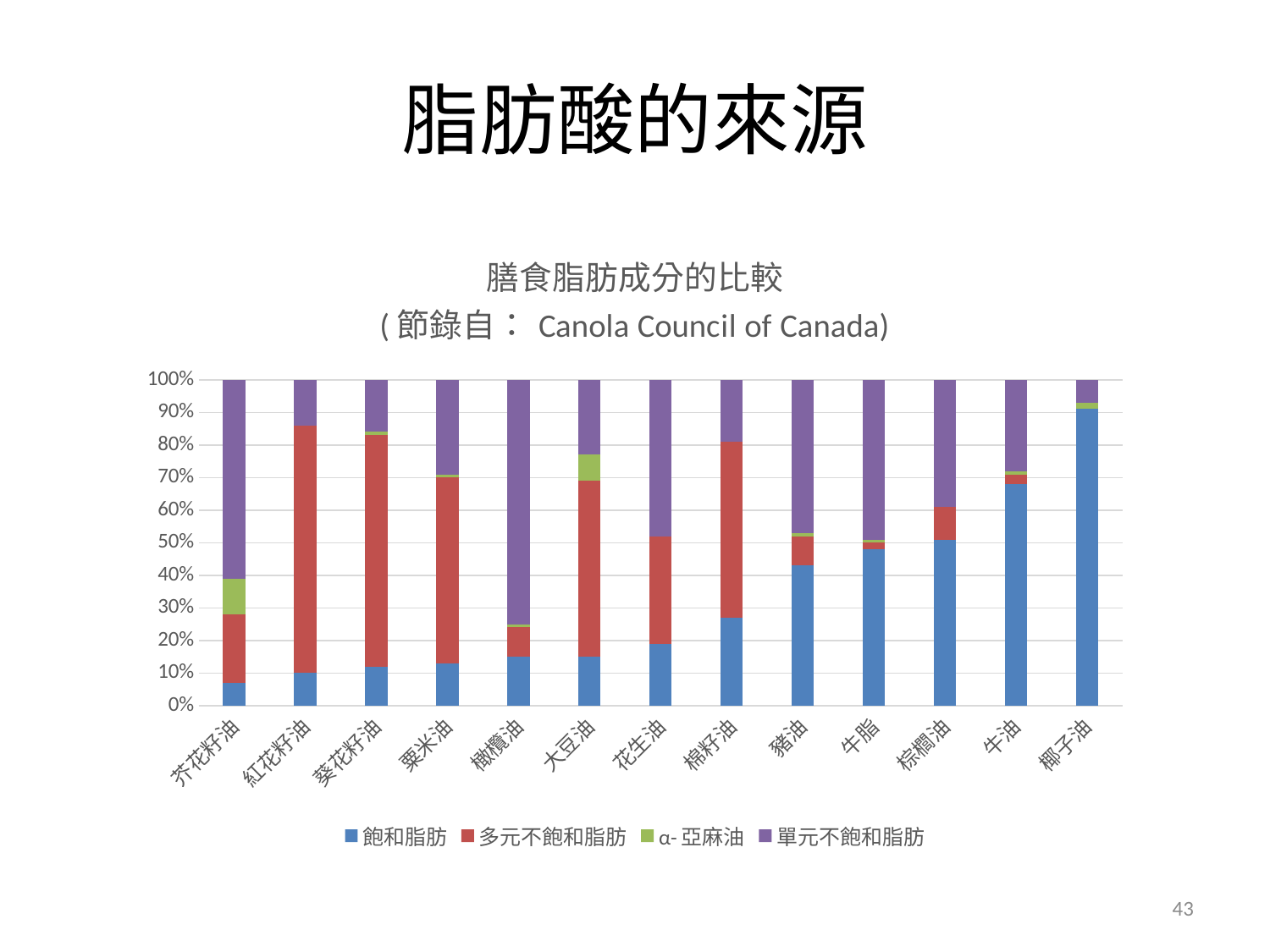
How many oils or fats are shown along the x axis of the chart? 13 Which has a larger share of 飽和脂肪, 牛油 or 豬油? 牛油 Is the 飽和脂肪 share for 牛油 greater or less than 60%? greater Is the 飽和脂肪 share for 豬油 greater or less than 50%? less Which series is shown in purple in the chart legend? 單元不飽和脂肪 Is the 飽和脂肪 share for 芥花籽油 greater or less than 10%? less Which oil or fat has the lowest share of 飽和脂肪 (saturated fat)? 芥花籽油 What is the first line of the chart title? 膳食脂肪成分的比較 What kind of chart is shown on the slide? Stacked bar chart Which oil or fat has the highest share of 飽和脂肪 (saturated fat)? 椰子油 How many series does the chart legend list? 4